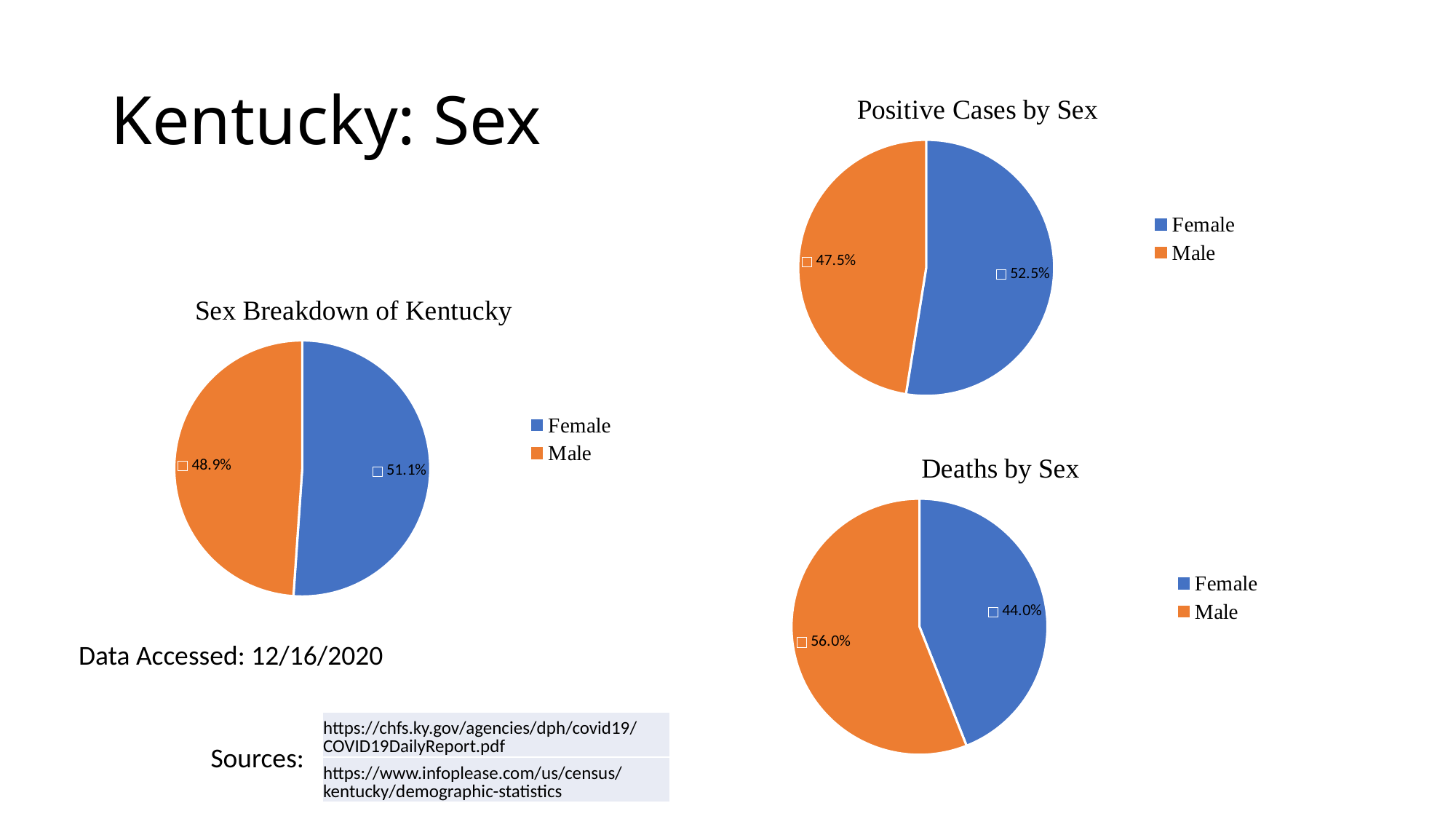
In the 'Deaths by Sex' chart, what is the difference between the Male and Female percentages? 12.0% In the 'Deaths by Sex' chart, what percentage is Male? 56.0% How many categories does the legend of the 'Deaths by Sex' chart list? 2 In the 'Deaths by Sex' chart, which category has the larger share? Male In the 'Positive Cases by Sex' chart, what percentage is Male? 47.5% In the 'Positive Cases by Sex' chart, which category has the smaller share? Male In the 'Positive Cases by Sex' chart, what is the difference between the Female and Male percentages? 5.0% In the 'Sex Breakdown of Kentucky' chart, what percentage is Female? 51.1% In the 'Positive Cases by Sex' chart, what percentage is Female? 52.5% What type of chart is 'Sex Breakdown of Kentucky'? Pie chart In the 'Deaths by Sex' chart, what percentage is Female? 44.0% In the 'Sex Breakdown of Kentucky' chart, what percentage is Male? 48.9%